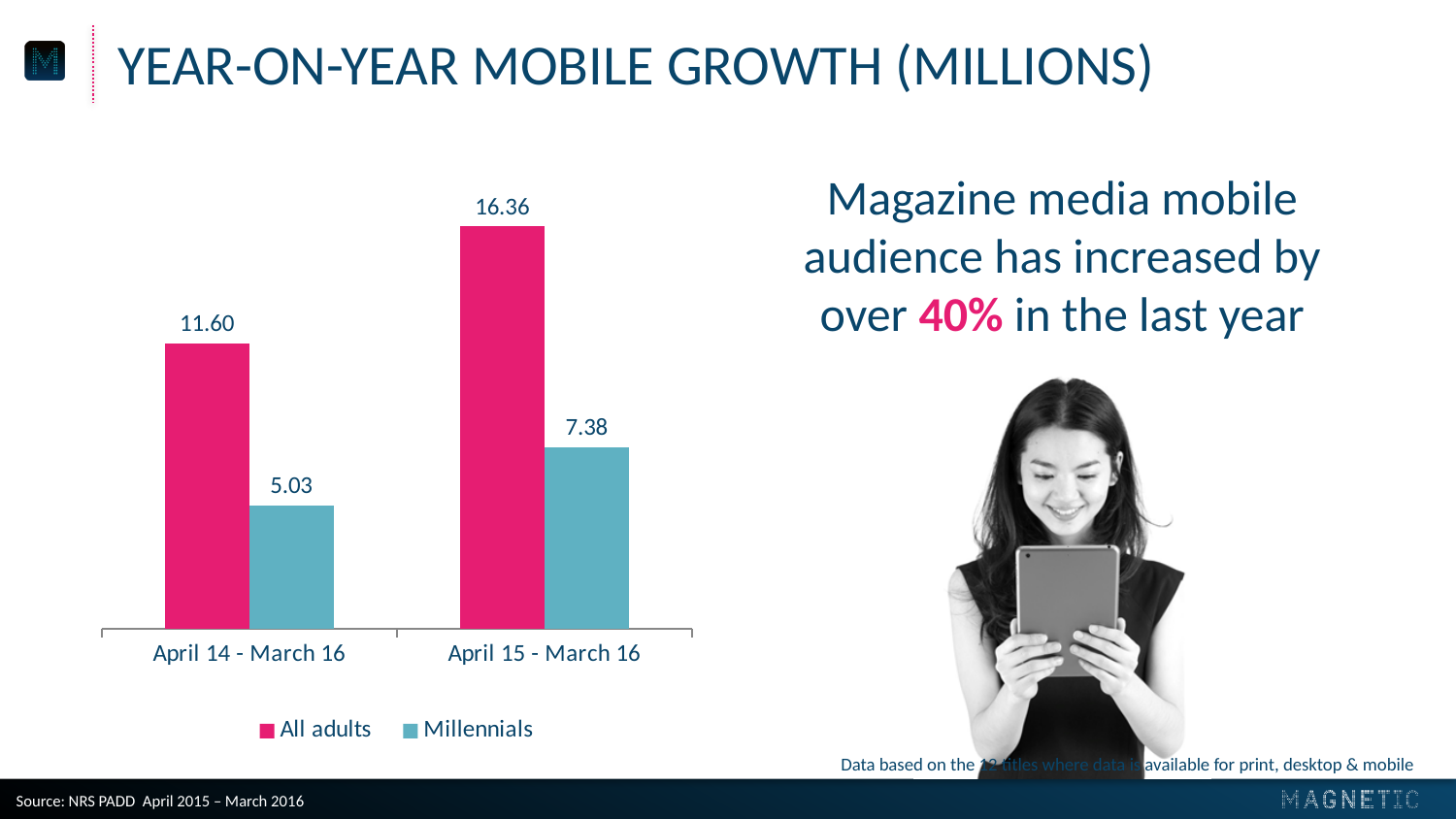
What is the value for All adults in April 14 - March 16? 11.60 What is the value for Millennials in April 15 - March 16? 7.38 Do the All adults values rise or fall from April 14 - March 16 to April 15 - March 16? Rise Which bar has the lowest value on the chart? Millennials, April 14 - March 16 Which is larger: All adults in April 14 - March 16 or Millennials in April 15 - March 16? All adults in April 14 - March 16 What kind of chart is shown on the slide? Bar chart What is the value for All adults in April 15 - March 16? 16.36 What is the difference between the Millennials values for April 15 - March 16 and April 14 - March 16? 2.35 How many series does the legend list? 2 What is the value for Millennials in April 14 - March 16? 5.03 Which bar has the highest value on the chart? All adults, April 15 - March 16 What is the difference between the All adults values for April 15 - March 16 and April 14 - March 16? 4.76